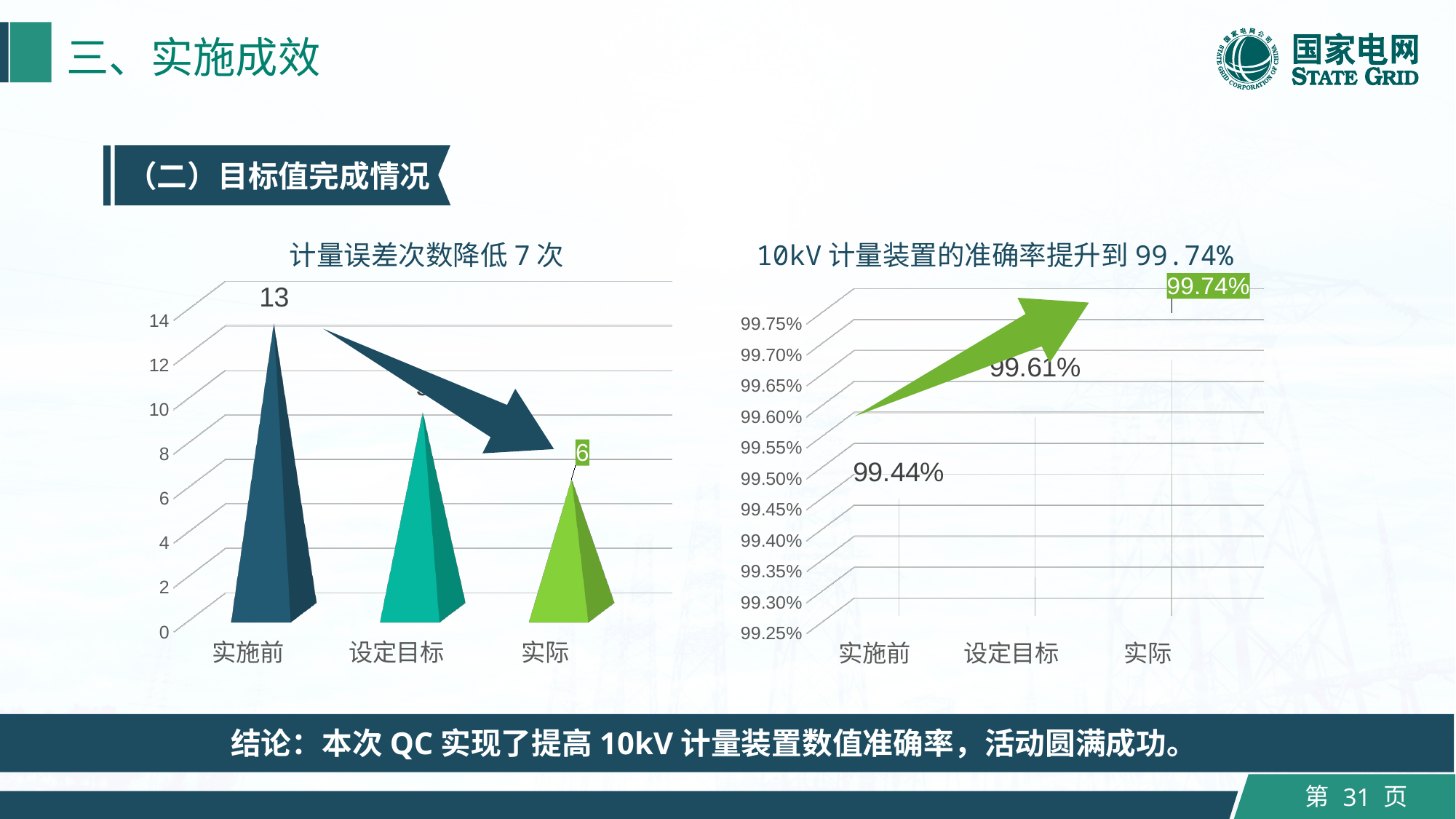
In the right chart titled 10kV计量装置的准确率提升到99.74%, which is larger, the value for 实际 or the value for 设定目标? 实际 In the left chart titled 计量误差次数降低7次, which category has the lowest value? 实际 In the right chart titled 10kV计量装置的准确率提升到99.74%, what is the value for 实际? 99.74% In the left chart titled 计量误差次数降低7次, what is the value for 实际? 6 In the left chart titled 计量误差次数降低7次, is the value for 设定目标 greater or less than 12? less How many categories are shown on the x axis of the right chart titled 10kV计量装置的准确率提升到99.74%? 3 In the left chart titled 计量误差次数降低7次, which category has the highest value? 实施前 In the right chart titled 10kV计量装置的准确率提升到99.74%, what is the value for 设定目标? 99.61% In the left chart titled 计量误差次数降低7次, what is the value for 实施前? 13 In the right chart titled 10kV计量装置的准确率提升到99.74%, what is the value for 实施前? 99.44% In the right chart titled 10kV计量装置的准确率提升到99.74%, do the values rise or fall from 实施前 to 实际? rise In the left chart titled 计量误差次数降低7次, what is the difference between the values for 实施前 and 实际? 7